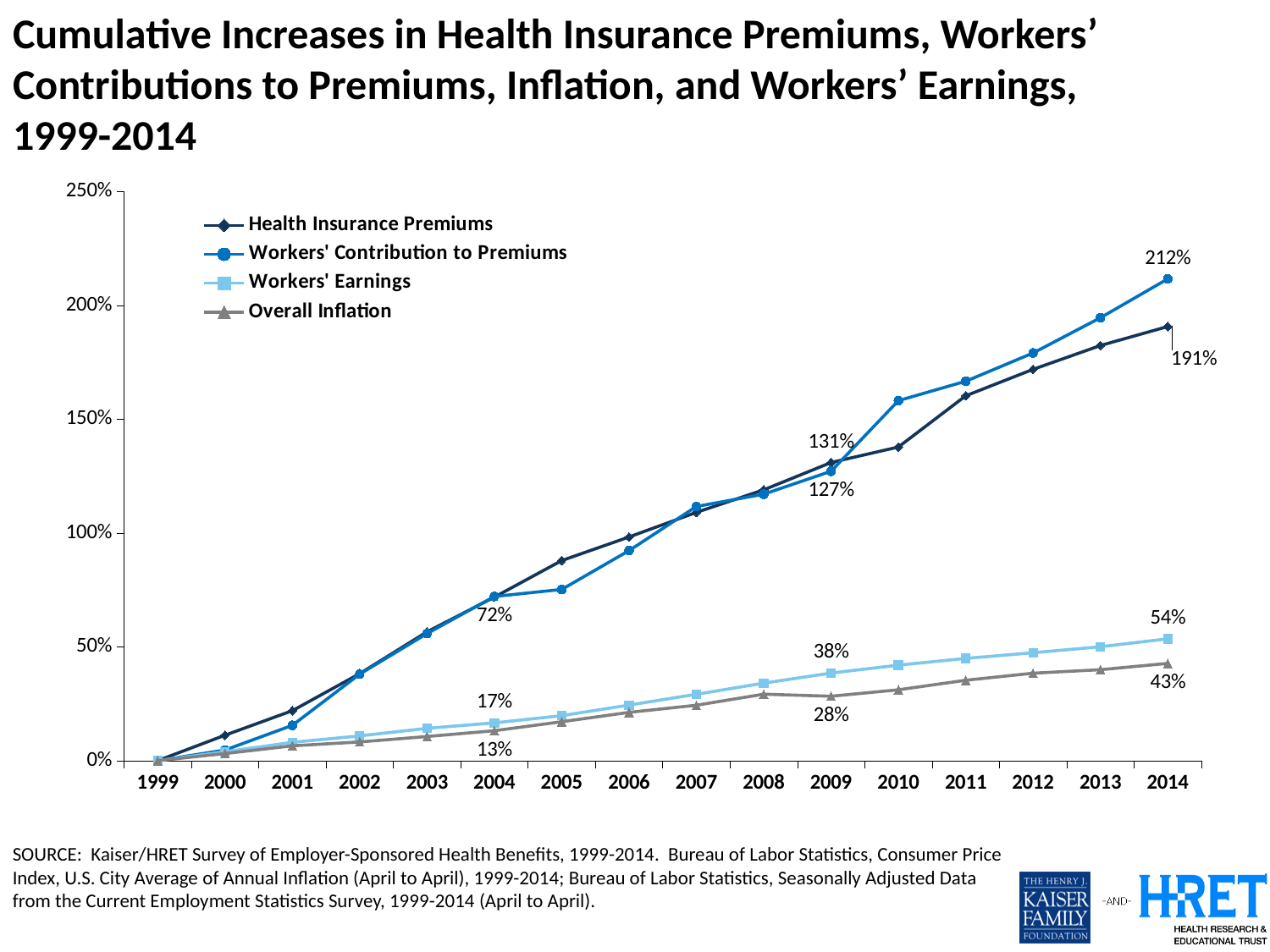
What is the cumulative increase in Workers' Contribution to Premiums in 2014? 212% What is the value for Overall Inflation in 2009? 28% In 2009, which is larger: Health Insurance Premiums or Workers' Contribution to Premiums? Health Insurance Premiums Which series has the highest value in 2014? Workers' Contribution to Premiums How many series does the legend list? 4 What is the difference between Workers' Earnings and Overall Inflation in 2014? 11 percentage points What kind of chart is shown on the slide? Line chart What is the difference between Workers' Contribution to Premiums and Health Insurance Premiums in 2014? 21 percentage points What is the cumulative increase in Health Insurance Premiums in 2014? 191% What is the value for Workers' Earnings in 2014? 54% How many years are shown on the x axis? 16 Is the value for Health Insurance Premiums in 2010 greater or less than 150%? less